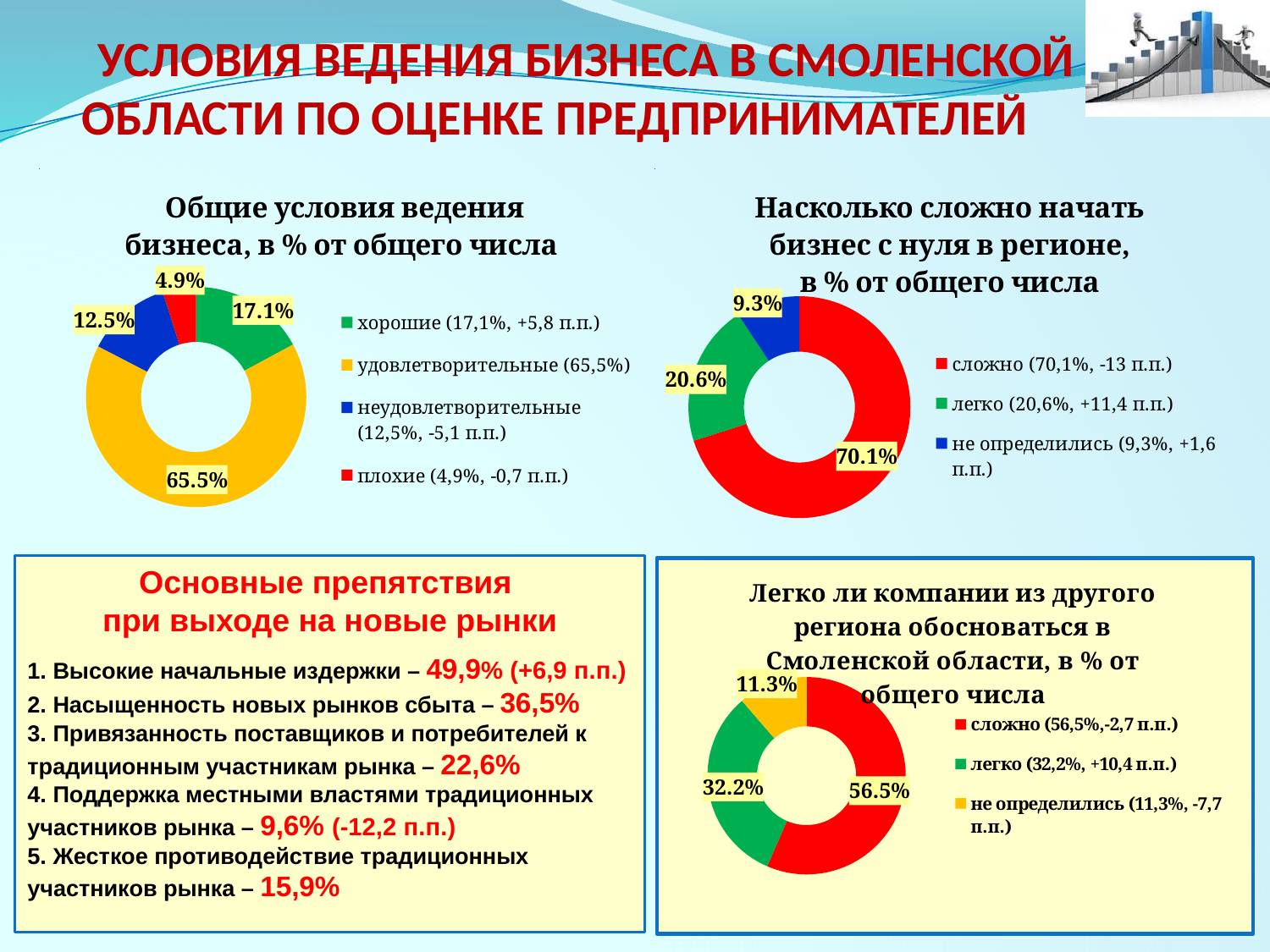
In the chart 'Легко ли компании из другого региона обосноваться в Смоленской области, в % от общего числа', what is the value for 'не определились'? 11.3% In the chart 'Общие условия ведения бизнеса, в % от общего числа', what is the difference between 'хорошие' and 'неудовлетворительные'? 4.6% What type of chart is 'Насколько сложно начать бизнес с нуля в регионе, в % от общего числа'? Doughnut chart How many entries does the legend of the chart 'Легко ли компании из другого региона обосноваться в Смоленской области, в % от общего числа' list? 3 In the chart 'Общие условия ведения бизнеса, в % от общего числа', what is the value for 'удовлетворительные'? 65.5% In the chart 'Общие условия ведения бизнеса, в % от общего числа', what colour is the 'удовлетворительные' segment? Yellow In the chart 'Насколько сложно начать бизнес с нуля в регионе, в % от общего числа', which category has the largest share? сложно In the chart 'Общие условия ведения бизнеса, в % от общего числа', which category has the smallest share? плохие In the chart 'Насколько сложно начать бизнес с нуля в регионе, в % от общего числа', what is the difference between 'сложно' and 'легко'? 49.5% In the chart 'Насколько сложно начать бизнес с нуля в регионе, в % от общего числа', what is the value for 'легко'? 20.6% How many categories does the chart 'Общие условия ведения бизнеса, в % от общего числа' show? 4 In the chart 'Легко ли компании из другого региона обосноваться в Смоленской области, в % от общего числа', which is larger: 'сложно' or 'легко'? сложно